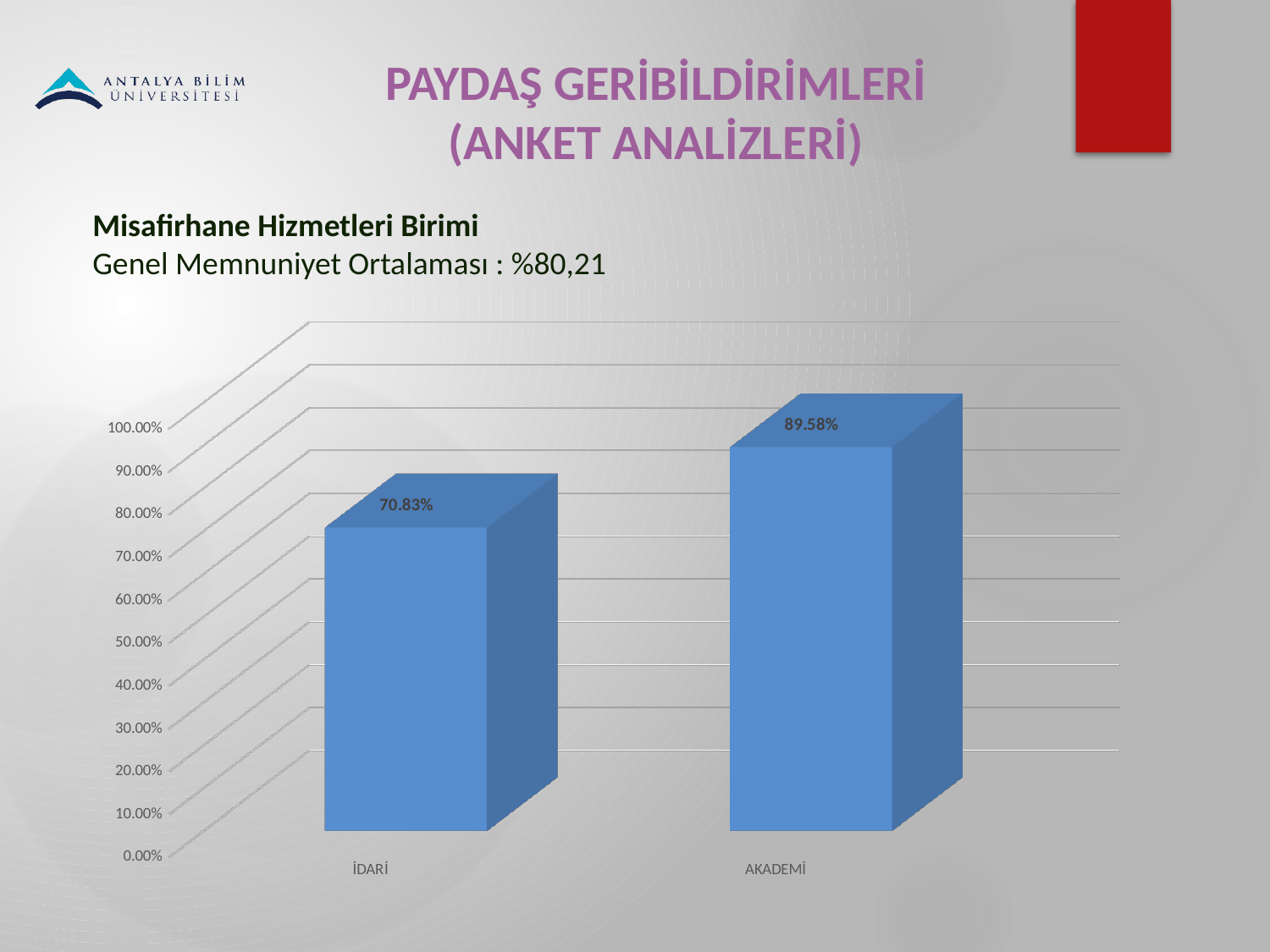
What is the value for İDARİ? 70.83% How many categories are shown on the x axis? 2 What is the highest value shown on the vertical axis? 100.00% Which category has the highest value? AKADEMİ Which category has the lowest value? İDARİ What is the difference between the values for AKADEMİ and İDARİ? 18.75% Which is larger, the value for İDARİ or the value for AKADEMİ? AKADEMİ Is the value for AKADEMİ greater or less than 80.00%? greater Is the value for İDARİ greater or less than 80.00%? less Do the values rise or fall from İDARİ to AKADEMİ? rise What is the value for AKADEMİ? 89.58% What kind of chart is shown on the slide? bar chart